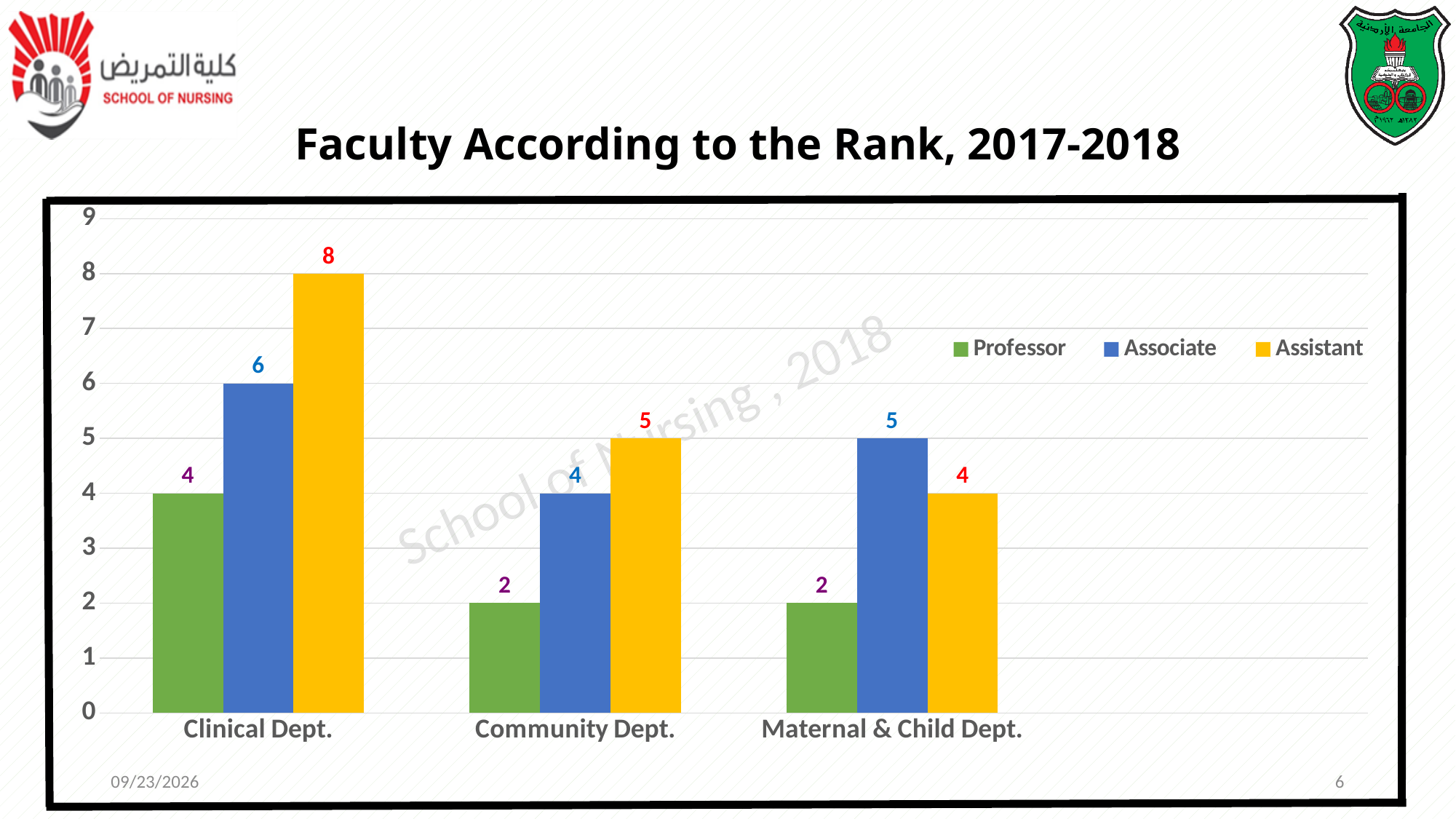
Which department has the highest Assistant value? Clinical Dept. How many departments are shown on the x axis? 3 What is the value for Associate in the Maternal & Child Dept.? 5 What is the difference between the Assistant and Professor values in the Clinical Dept.? 4 What is the title of the chart? Faculty According to the Rank, 2017-2018 How many series does the legend list? 3 What is the value for Professor in the Community Dept.? 2 Which colour represents the Assistant series? Yellow In the Maternal & Child Dept., which is larger, Associate or Assistant? Associate Which department has the lowest Associate value? Community Dept. How many Assistant faculty are in the Clinical Dept.? 8 What kind of chart is shown on the slide? Bar chart